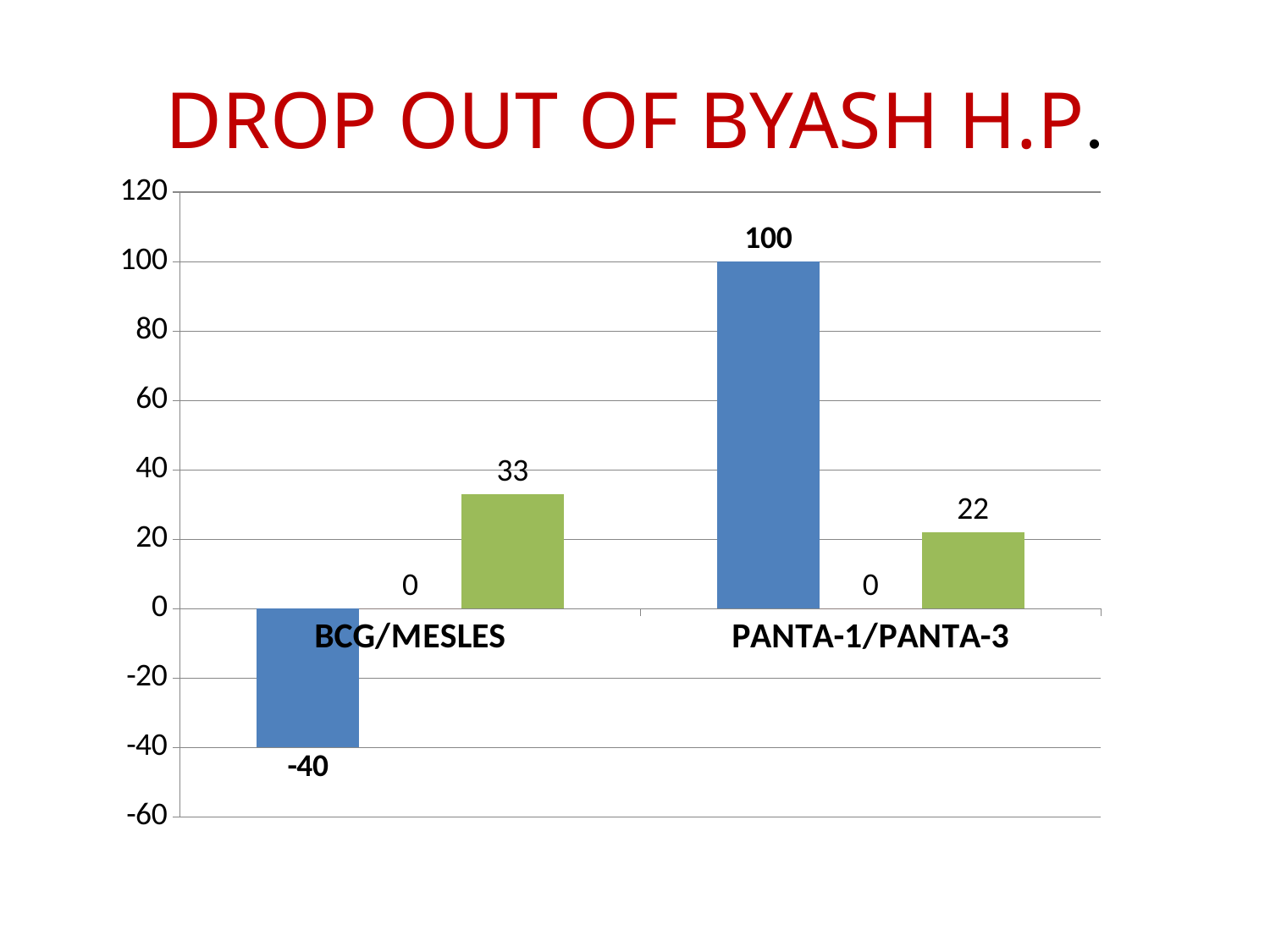
How many categories are shown on the x axis? 2 What is the value of the blue bar for BCG/MESLES? -40 What is the difference between the blue bar for PANTA-1/PANTA-3 and the green bar for PANTA-1/PANTA-3? 78 What is the highest value shown on the vertical axis? 120 What is the value of the green bar for PANTA-1/PANTA-3? 22 What kind of chart is shown on the slide? Bar chart Which category has the highest plotted value? PANTA-1/PANTA-3 What is the title of the slide? DROP OUT OF BYASH H.P. What is the value of the green bar for BCG/MESLES? 33 Which is larger, the green bar for BCG/MESLES or the green bar for PANTA-1/PANTA-3? BCG/MESLES Which category has the lowest plotted value? BCG/MESLES What is the value of the blue bar for PANTA-1/PANTA-3? 100